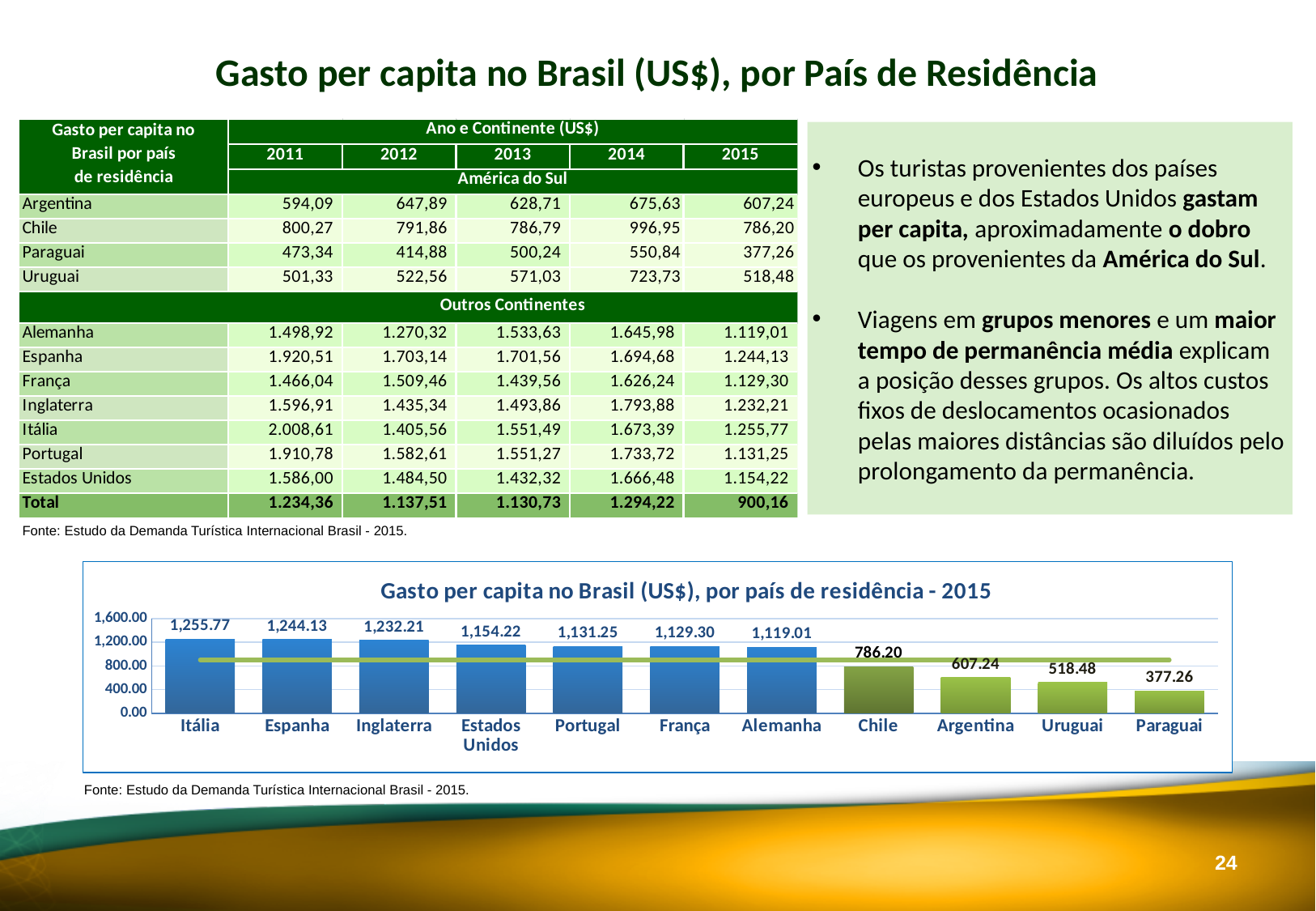
What is the value shown for Paraguai in the chart? 377.26 What type of chart is shown on the slide? combination bar and line chart What is the per capita spending value shown for Itália in the chart? 1,255.77 Which has a larger value in the chart, Chile or Uruguai? Chile What is the difference between the values for Chile and Argentina in the chart? 178.96 Do the values in the chart rise or fall from left to right? fall Which country has the highest per capita spending in the chart? Itália Is the value for Argentina in the chart greater or less than 800? less What is the value shown for Chile in the chart? 786.20 What is the difference between the values for Itália and Paraguai in the chart? 878.51 How many countries are shown in the chart? 11 Which country has the lowest per capita spending in the chart? Paraguai